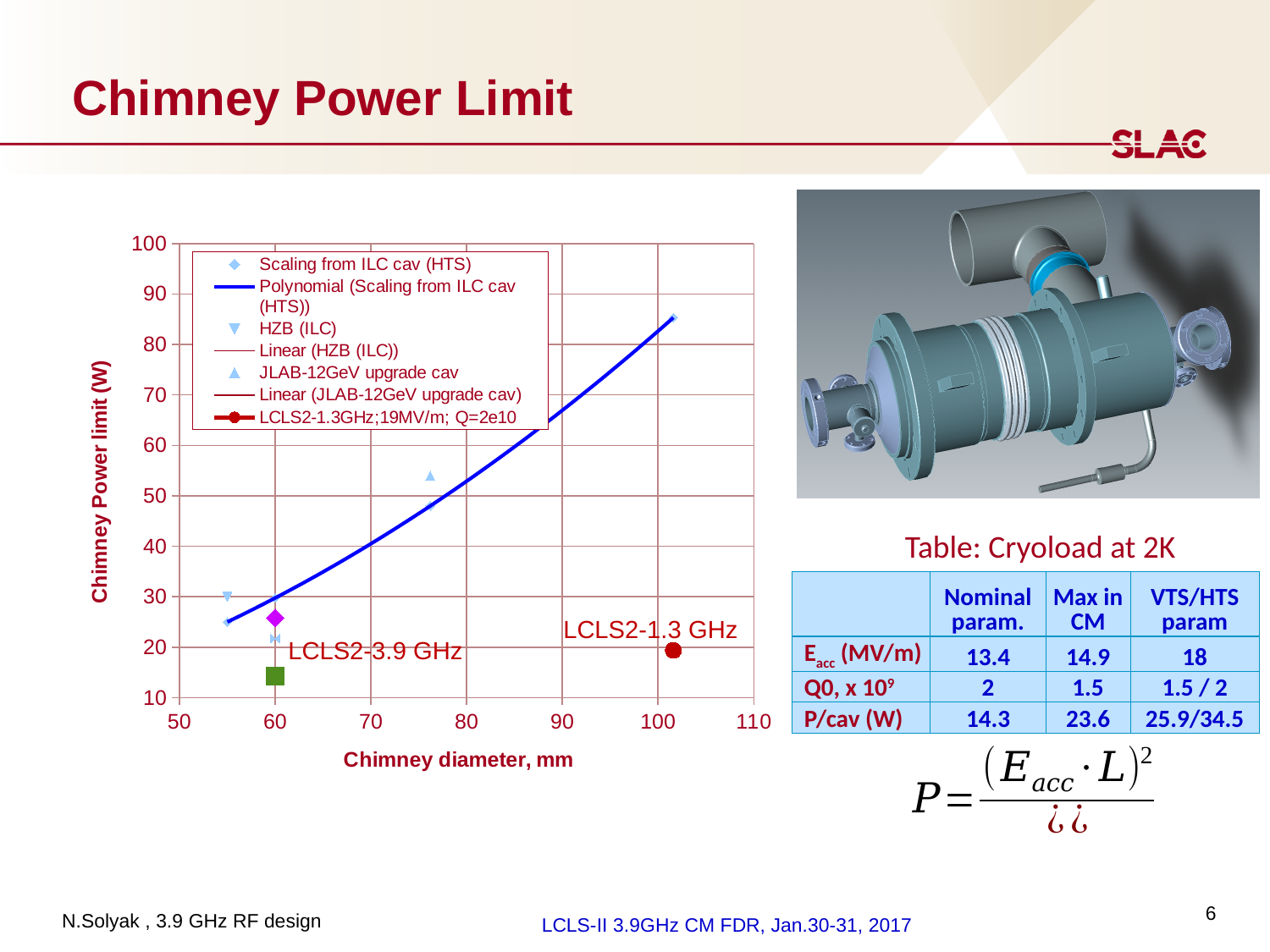
What is the maximum value shown on the y axis of the chart? 100 What is the title of the x axis of the chart? Chimney diameter, mm Is the chimney power limit for the LCLS2-1.3 GHz point greater or less than 30 W? less Is the chimney power limit for the JLAB-12GeV upgrade cav point greater or less than 50 W? greater What kind of chart is shown on the slide? Scatter chart Is the chimney power limit for the Scaling from ILC cav (HTS) point near 100 mm diameter greater or less than 80 W? greater What is the title of the y axis of the chart? Chimney Power limit (W) Which point has a higher chimney power limit: the JLAB-12GeV upgrade cav point or the LCLS2-1.3 GHz point? JLAB-12GeV upgrade cav Does the blue polynomial trend line rise or fall as chimney diameter increases? Rises How many entries does the chart legend list? 7